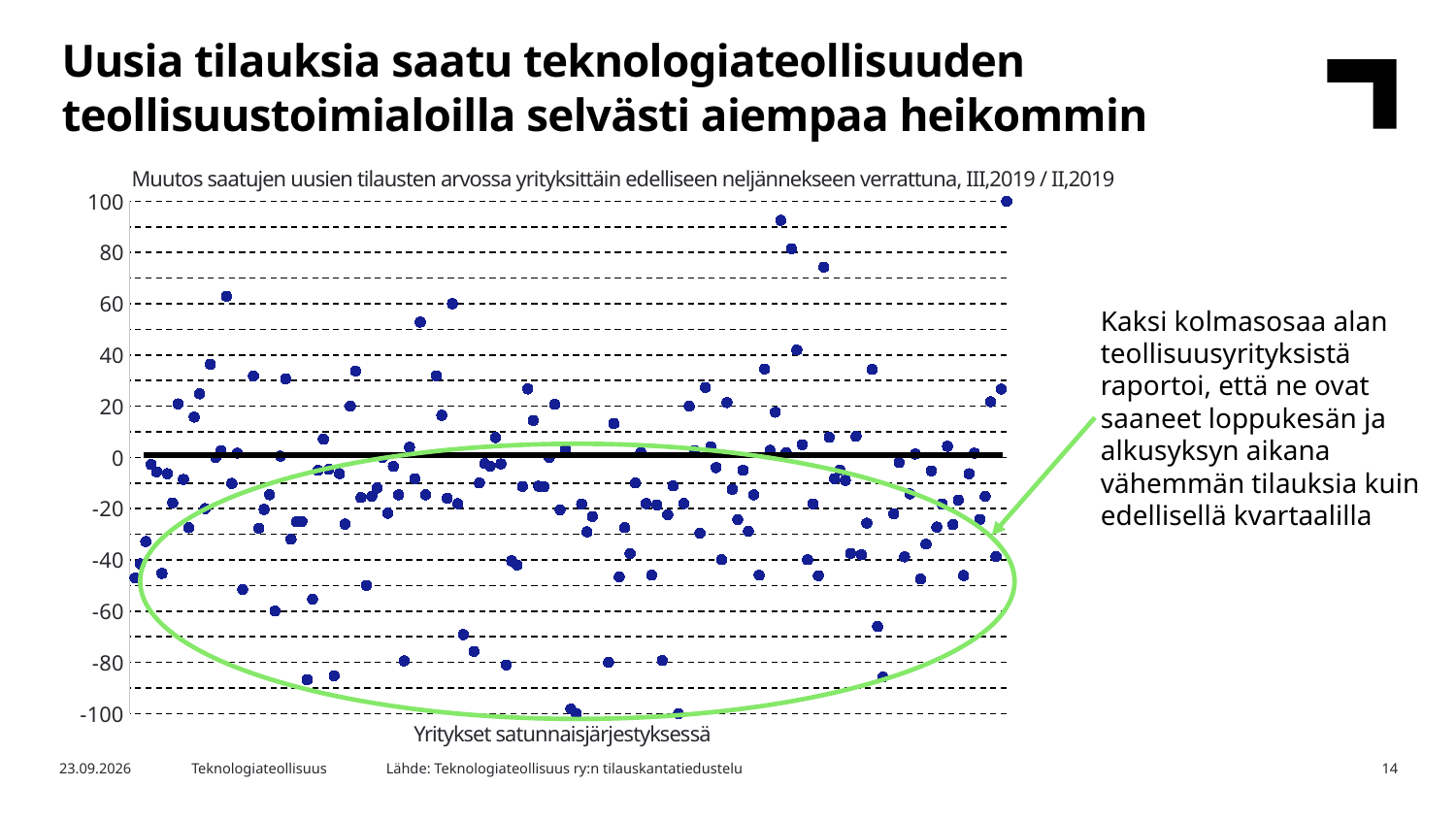
Is the lowest plotted point in the chart greater or less than -80? less What kind of chart is shown on the slide? Scatter chart What is the highest value shown on the y axis of the chart? 100 What is the label of the x axis of the chart? Yritykset satunnaisjärjestyksessä Is the highest plotted point in the chart greater or less than 80? greater What is the lowest value shown on the y axis of the chart? -100 What is the title of the chart? Muutos saatujen uusien tilausten arvossa yrityksittäin edelliseen neljännekseen verrattuna, III,2019 / II,2019 At what y-axis value is the solid black horizontal line drawn across the chart? 0